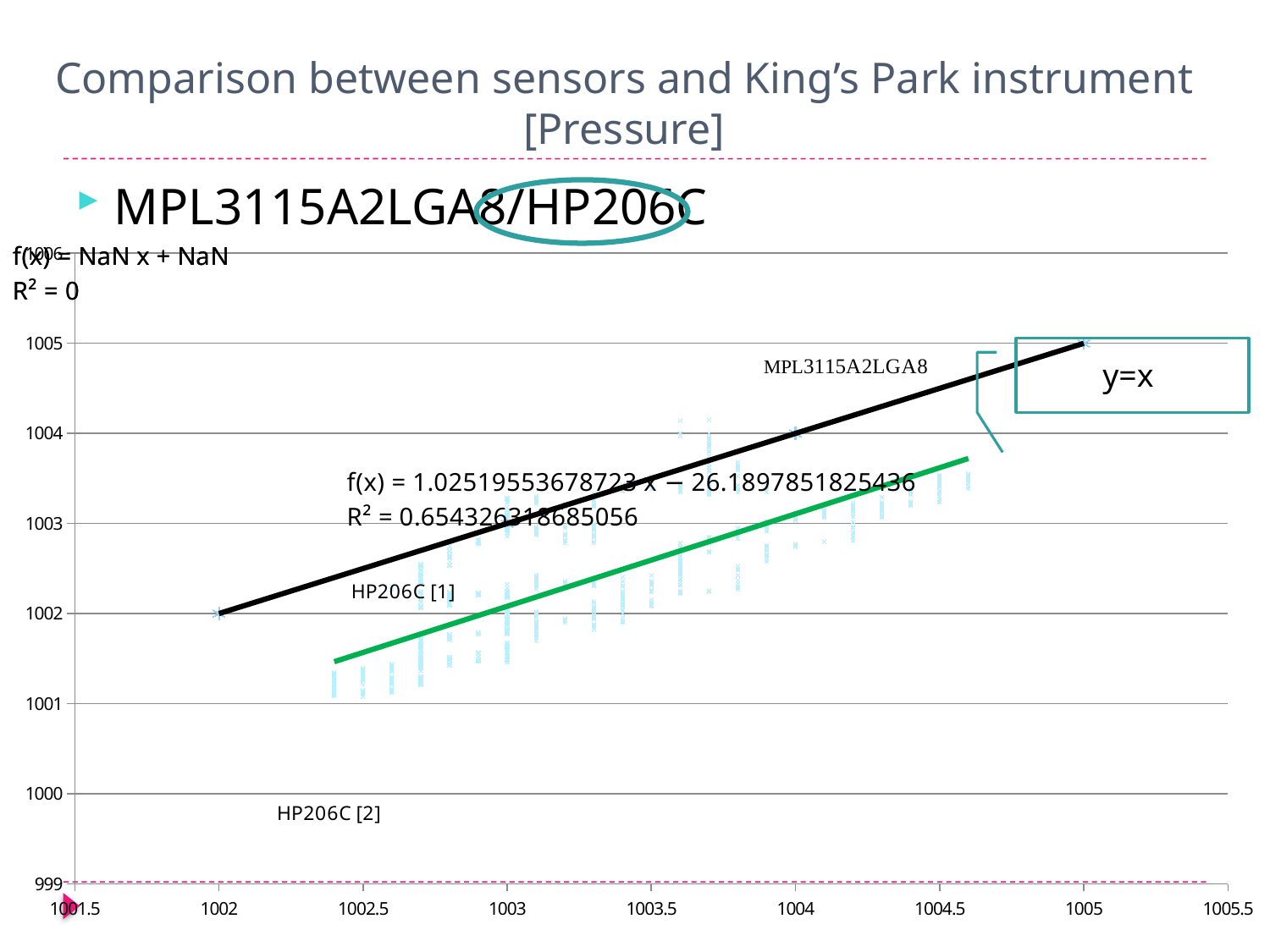
What is the highest tick value shown on the y axis? 1006 Do the scatter points rise or fall as the x-axis value increases? rise What does the boxed annotation say the black line represents? y=x What is the slope in the trendline equation f(x) = 1.02519553678723 x − 26.1897851825436? 1.02519553678723 Are the scatter points at x = 1002.5 greater or less than 1002 on the y axis? less Is the green trendline above or below the black y=x line? below What is the lowest tick value shown on the x axis? 1001.5 What is the R² value printed for the green trendline on the chart? 0.654326318685056 Which three series labels are printed on the chart? MPL3115A2LGA8, HP206C [1], HP206C [2] What kind of chart is shown on the slide? scatter chart What is the R² value printed at the top left of the chart for the NaN trendline? 0 What is the intercept in the trendline equation printed on the chart? −26.1897851825436